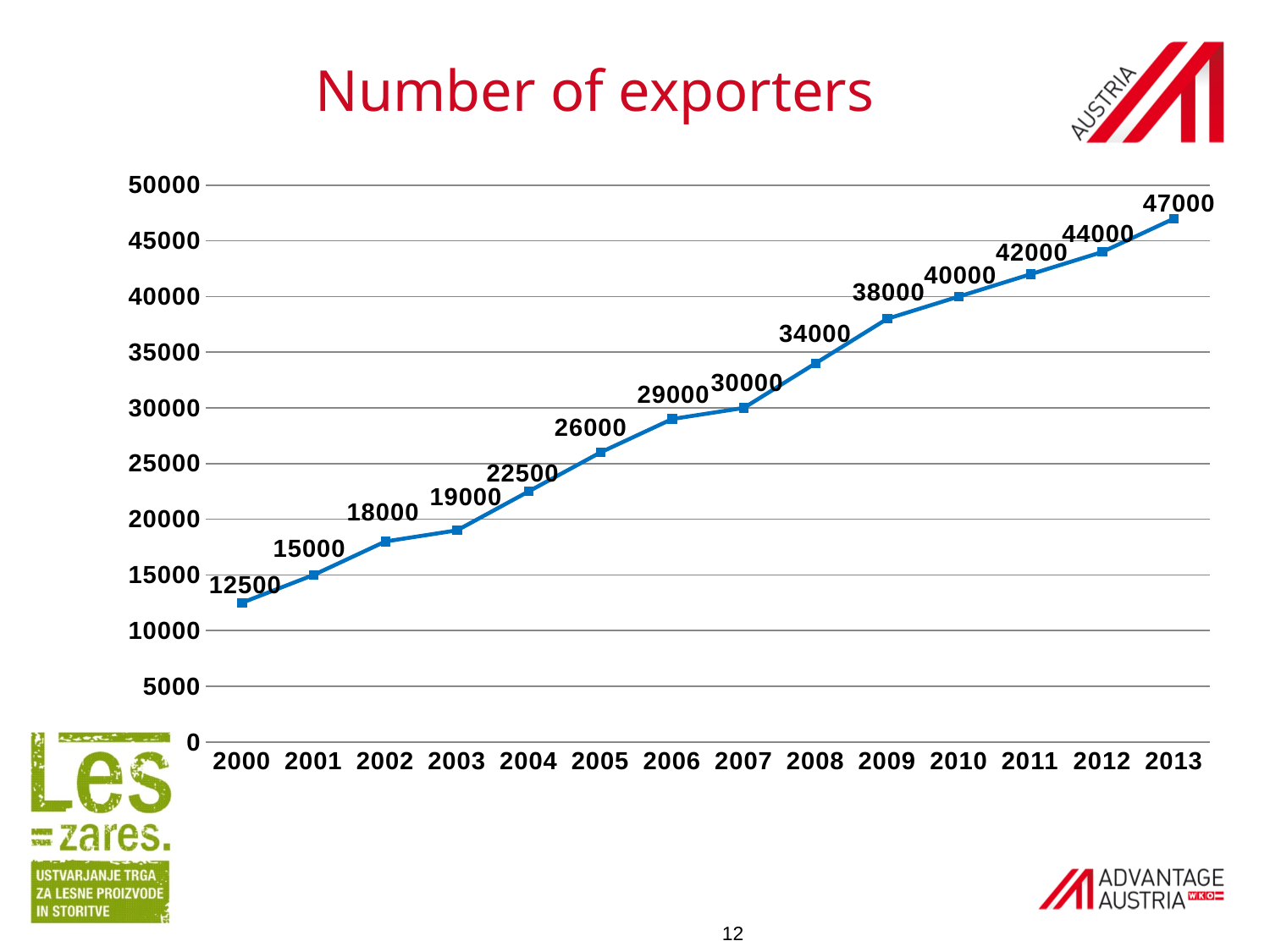
How many years are shown on the x axis? 14 What is the number of exporters in 2000? 12500 What is the number of exporters in 2008? 34000 Does the number of exporters rise or fall from 2000 to 2013? rise Is the number of exporters in 2010 greater or less than 35000? greater What is the difference in the number of exporters between 2013 and 2000? 34500 Which year has the highest number of exporters? 2013 What is the difference in the number of exporters between 2007 and 2006? 1000 What kind of chart is shown on the slide? line chart What is the number of exporters in 2013? 47000 Which year has more exporters, 2004 or 2009? 2009 Which year has the lowest number of exporters? 2000